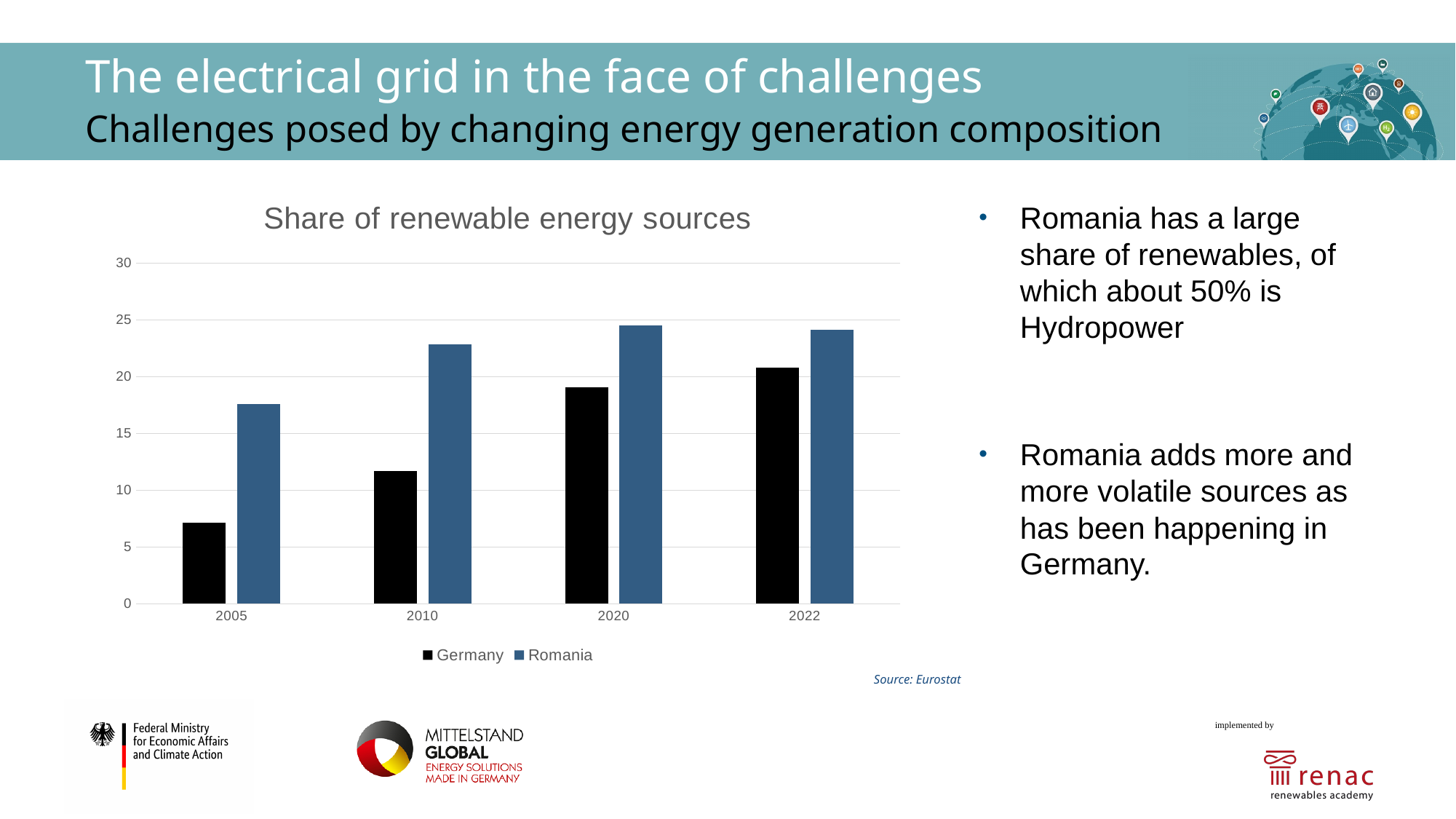
In which year is the value for Germany the lowest? 2005 Which series is shown in black in the chart? Germany Do the values for Germany rise or fall from 2005 to 2022? rise What kind of chart is shown on the slide? bar chart Is the value for Romania in 2010 greater or less than 20? greater Which is larger in 2020, the value for Germany or the value for Romania? Romania How many years are shown on the x axis of the chart? 4 What is the title of the chart? Share of renewable energy sources How many series does the chart legend list? 2 Is the value for Germany in 2005 greater or less than 10? less In which year is the value for Romania the lowest? 2005 In which year is the value for Germany the highest? 2022